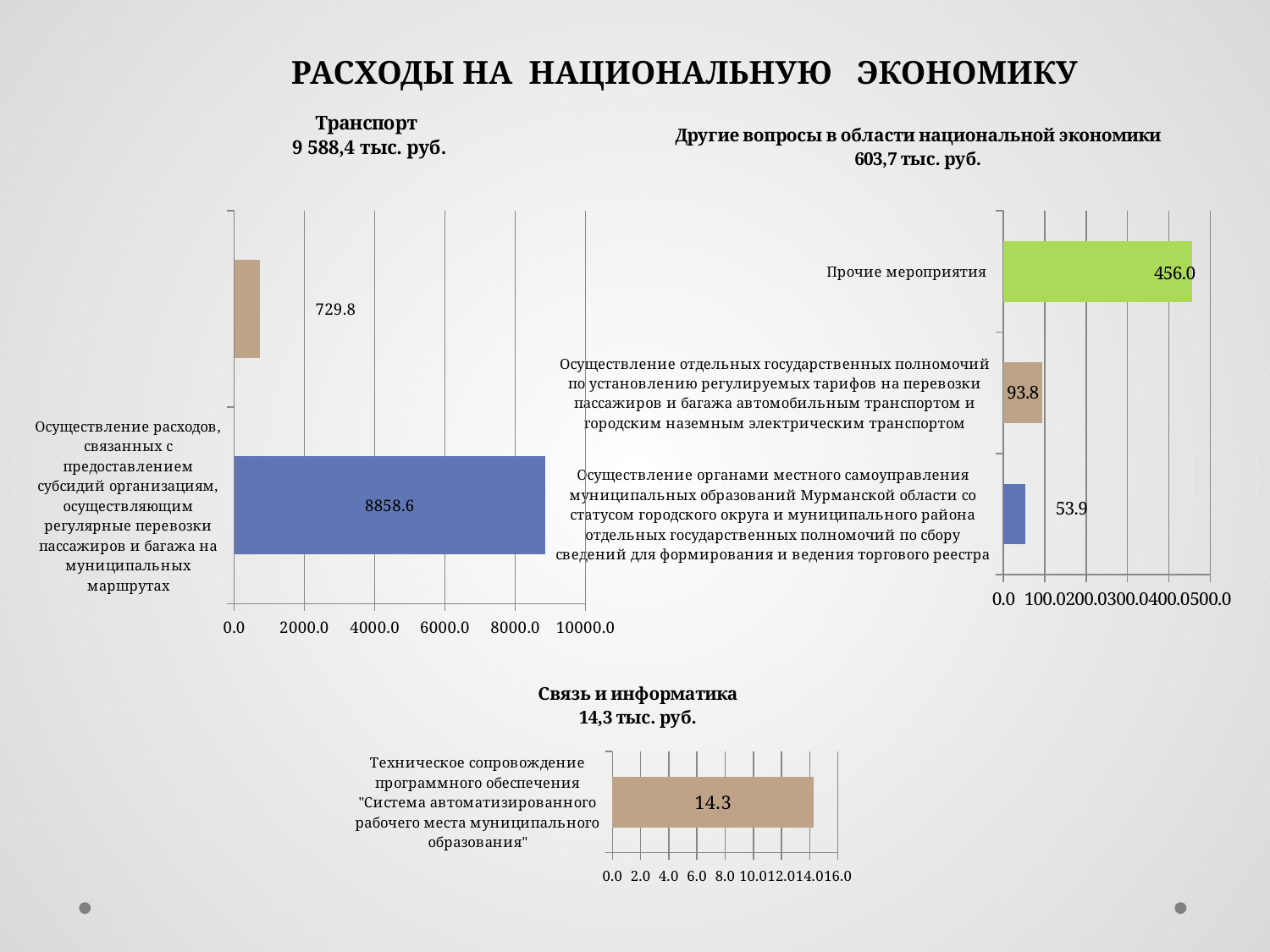
In the 'Транспорт' chart, how many bars are plotted? 2 In the 'Транспорт' chart, what is the difference between the two bar values? 8128.8 In the 'Связь и информатика' chart, what is the value for 'Техническое сопровождение программного обеспечения "Система автоматизированного рабочего места муниципального образования"'? 14.3 In the 'Транспорт' chart, what is the value shown on the smaller bar? 729.8 In the 'Другие вопросы в области национальной экономики' chart, what is the value for 'Осуществление отдельных государственных полномочий по установлению регулируемых тарифов на перевозки пассажиров и багажа автомобильным транспортом и городским наземным электрическим транспортом'? 93.8 In the 'Транспорт' chart, what is the value for 'Осуществление расходов, связанных с предоставлением субсидий организациям, осуществляющим регулярные перевозки пассажиров и багажа на муниципальных маршрутах'? 8858.6 In the 'Другие вопросы в области национальной экономики' chart, what is the value for 'Прочие мероприятия'? 456.0 In the 'Другие вопросы в области национальной экономики' chart, how many categories are plotted? 3 In the 'Другие вопросы в области национальной экономики' chart, what is the difference between 'Прочие мероприятия' and the category valued at 53.9? 402.1 What type of chart is the 'Связь и информатика' chart? bar chart In the 'Другие вопросы в области национальной экономики' chart, which category has the highest value? Прочие мероприятия